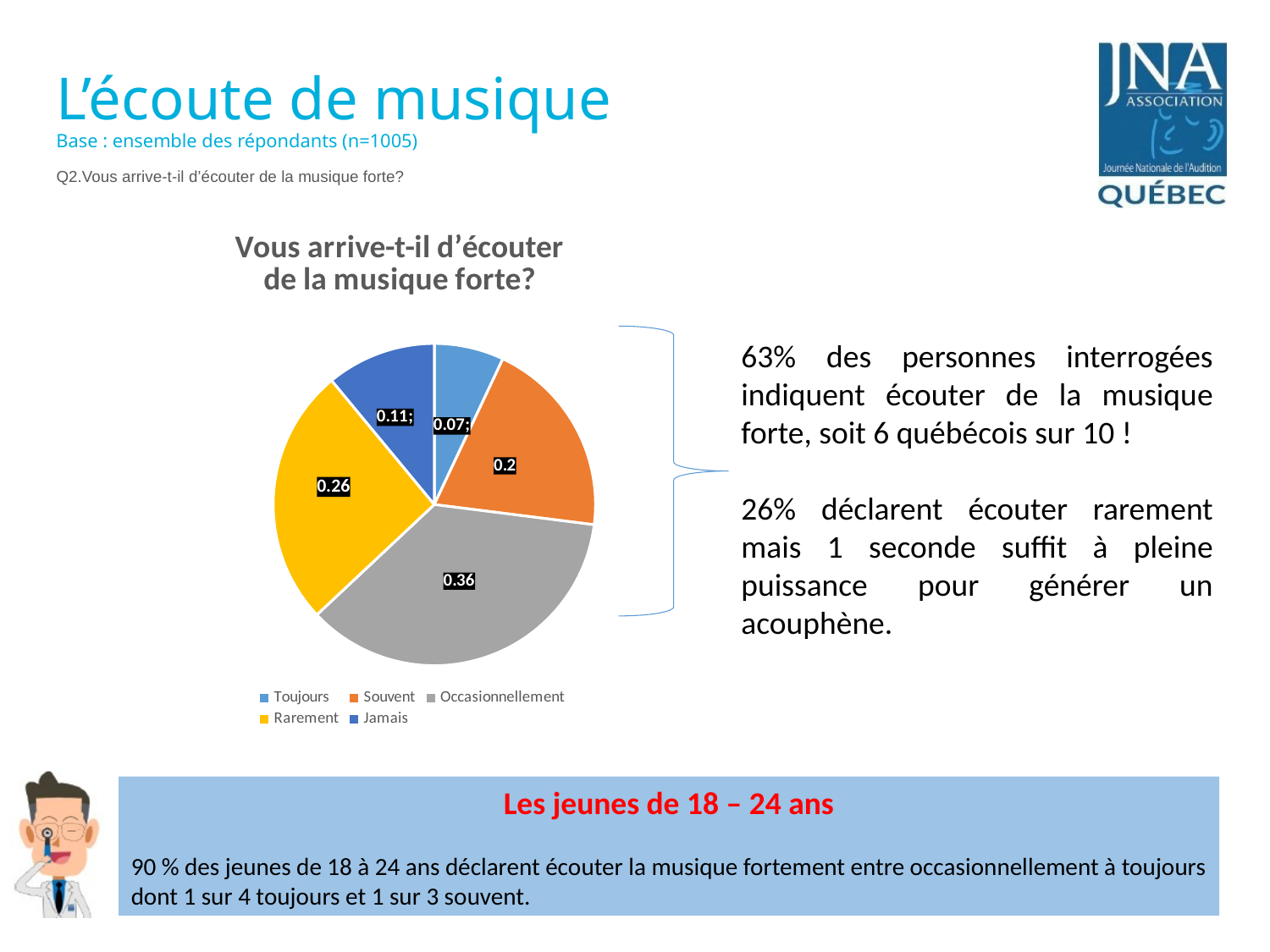
Which category has the largest slice in the pie chart? Occasionnellement What is the title of the pie chart? Vous arrive-t-il d'écouter de la musique forte? What kind of chart is shown on the slide? pie chart What is the value for Souvent in the pie chart? 0.2 How many categories does the pie chart show? 5 Which category has the smallest slice in the pie chart? Toujours What is the value for Occasionnellement in the pie chart? 0.36 What is the value for Jamais in the pie chart? 0.11 What is the difference between the values for Occasionnellement and Rarement? 0.1 What is the value for Toujours in the pie chart? 0.07 Which is larger, the value for Souvent or the value for Jamais? Souvent What is the value for Rarement in the pie chart? 0.26